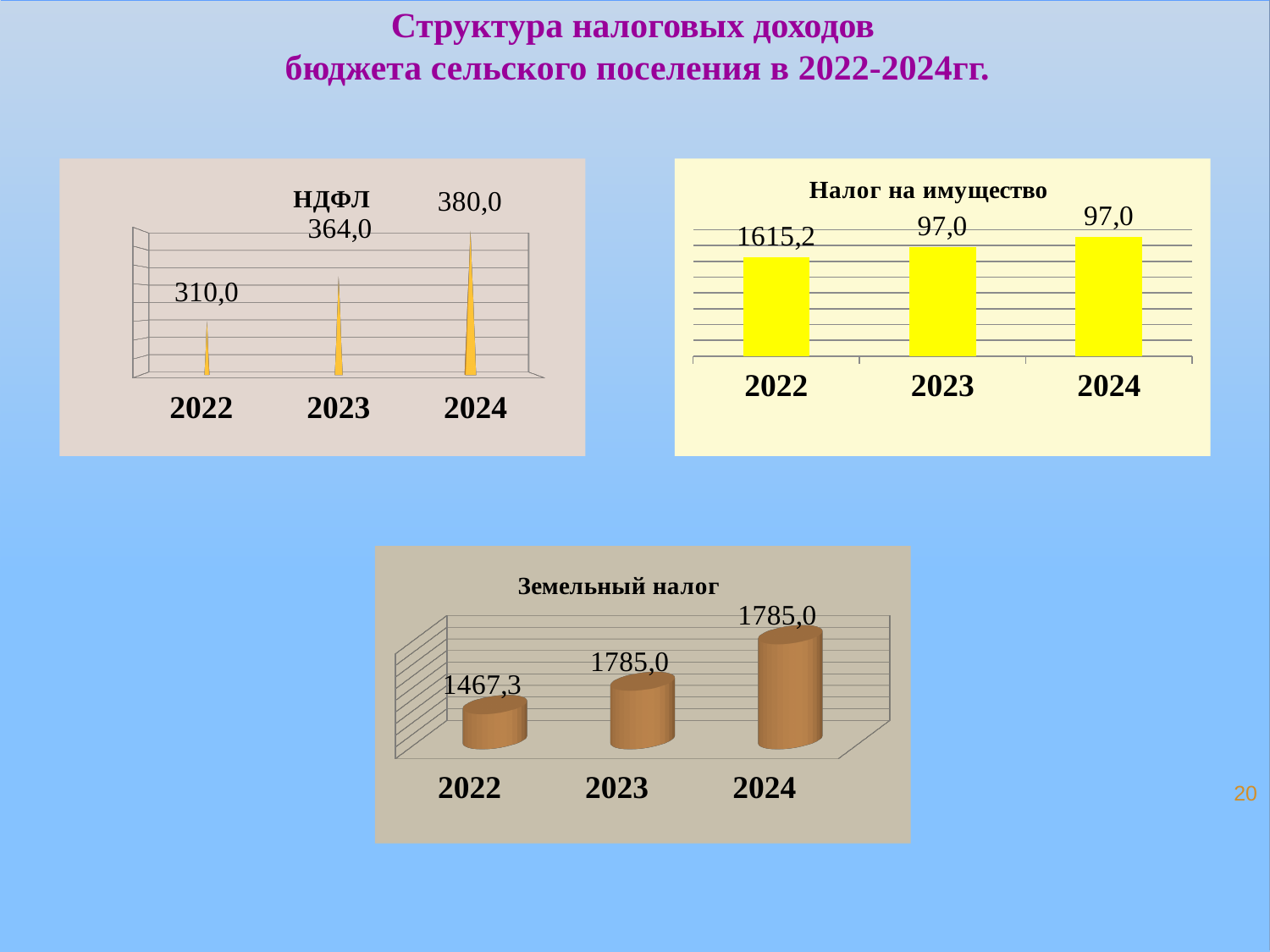
In the НДФЛ chart, which year has the highest value? 2024 In the Налог на имущество chart, what is the value for 2024? 97,0 In the Земельный налог chart, which year has the lowest value? 2022 In the Земельный налог chart, what is the difference between the 2023 and 2022 values? 317,7 In the Налог на имущество chart, how many years are shown? 3 In the Налог на имущество chart, what is the value labelled for 2022? 1615,2 In the НДФЛ chart, do the values rise or fall from 2022 to 2024? rise In the НДФЛ chart, what is the value for 2024? 380,0 In the НДФЛ chart, what is the value for 2022? 310,0 How many charts are shown on the slide? 3 In the НДФЛ chart, what is the difference between the 2023 and 2022 values? 54,0 In the Земельный налог chart, what is the value for 2022? 1467,3